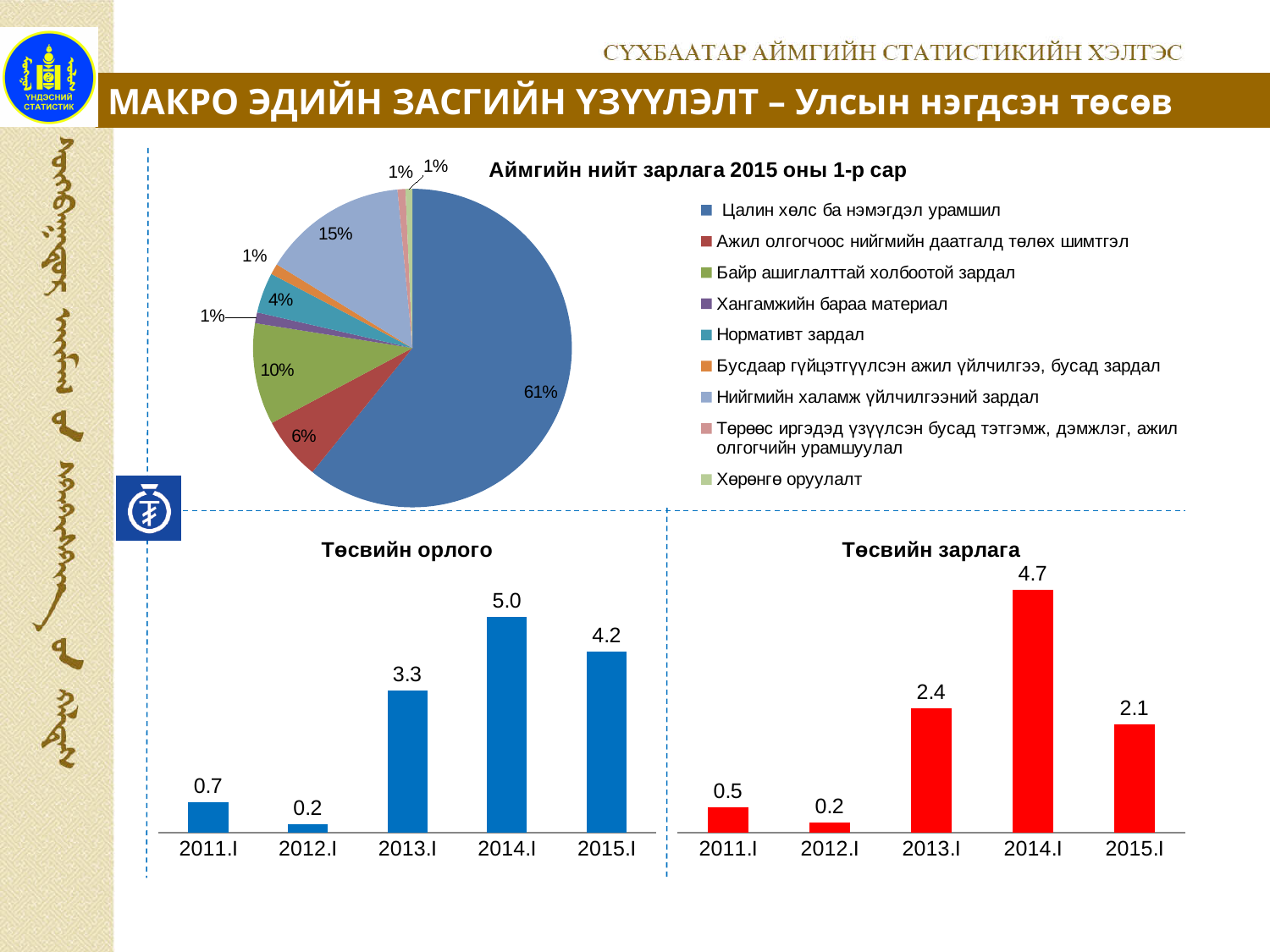
In the pie chart 'Аймгийн нийт зарлага 2015 оны 1-р сар', what share does 'Байр ашиглалттай холбоотой зардал' have? 10% In the chart 'Төсвийн орлого', which period has the lowest value? 2012.I How many entries does the legend of the pie chart 'Аймгийн нийт зарлага 2015 оны 1-р сар' list? 9 What kind of chart is 'Төсвийн зарлага'? Bar chart In the chart 'Төсвийн зарлага', which is larger, the value for 2011.I or 2015.I? 2015.I In the chart 'Төсвийн зарлага', what is the value for 2013.I? 2.4 In the pie chart 'Аймгийн нийт зарлага 2015 оны 1-р сар', what share does 'Цалин хөлс ба нэмэгдэл урамшил' have? 61% In the chart 'Төсвийн зарлага', which period has the highest value? 2014.I In the chart 'Төсвийн орлого', what is the difference between the values for 2014.I and 2015.I? 0.8 How many periods are shown on the x axis of the chart 'Төсвийн орлого'? 5 In the pie chart 'Аймгийн нийт зарлага 2015 оны 1-р сар', what share does 'Нийгмийн халамж үйлчилгээний зардал' have? 15% In the chart 'Төсвийн орлого', what is the value for 2014.I? 5.0